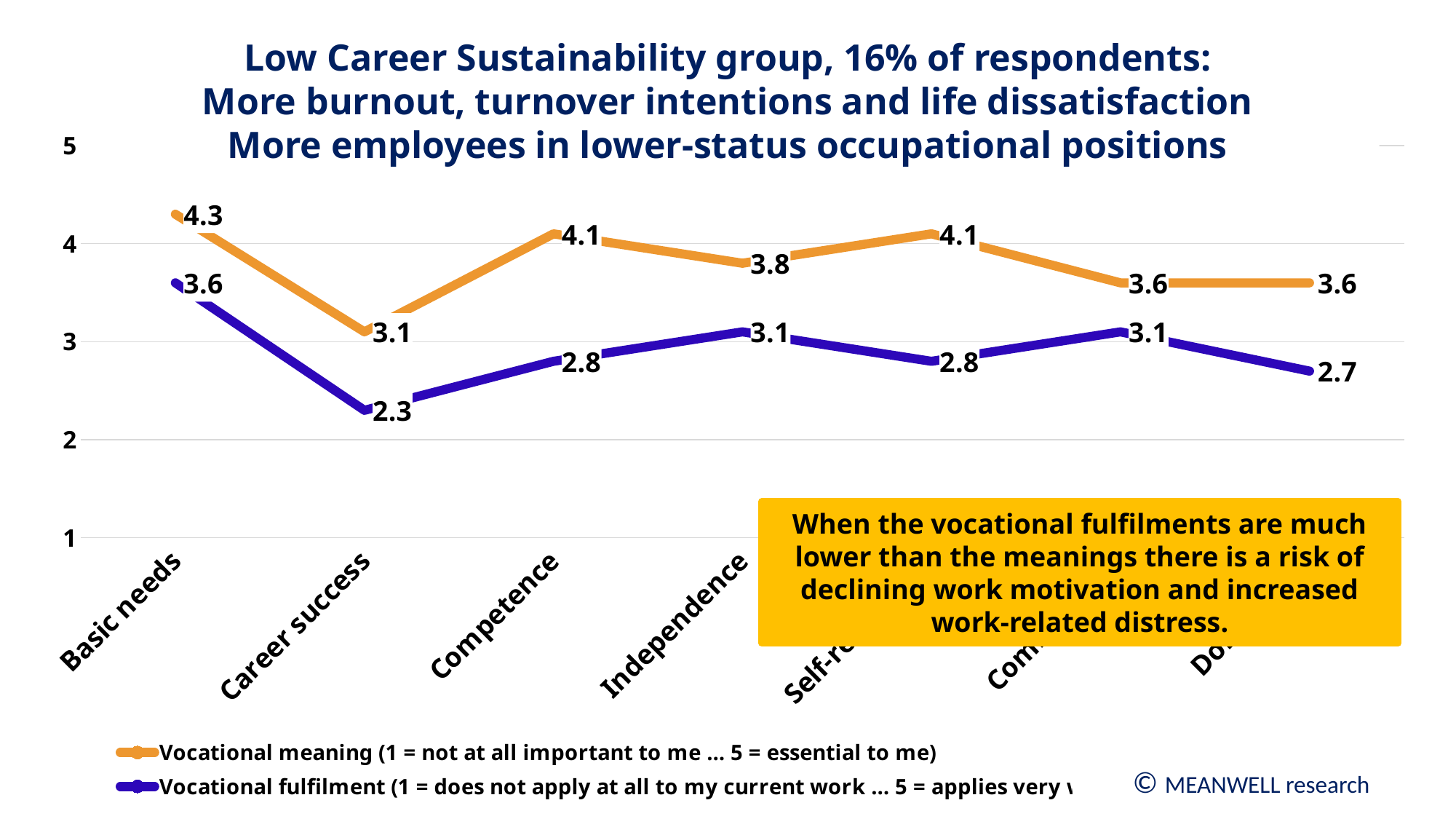
Which category has the lowest Vocational fulfilment value? Career success What is the difference between Vocational meaning and Vocational fulfilment for Competence? 1.3 What is the Vocational meaning value for Basic needs? 4.3 What is the Vocational meaning value for Competence? 4.1 Which is larger for Career success: Vocational meaning or Vocational fulfilment? Vocational meaning What kind of chart is shown on the slide? line chart Does the Vocational meaning line rise or fall from Basic needs to Career success? fall What colour is the Vocational fulfilment line? blue What is the Vocational fulfilment value for Independence? 3.1 How many series does the legend list? 2 What is the Vocational fulfilment value for Career success? 2.3 Which category has the highest Vocational meaning value? Basic needs